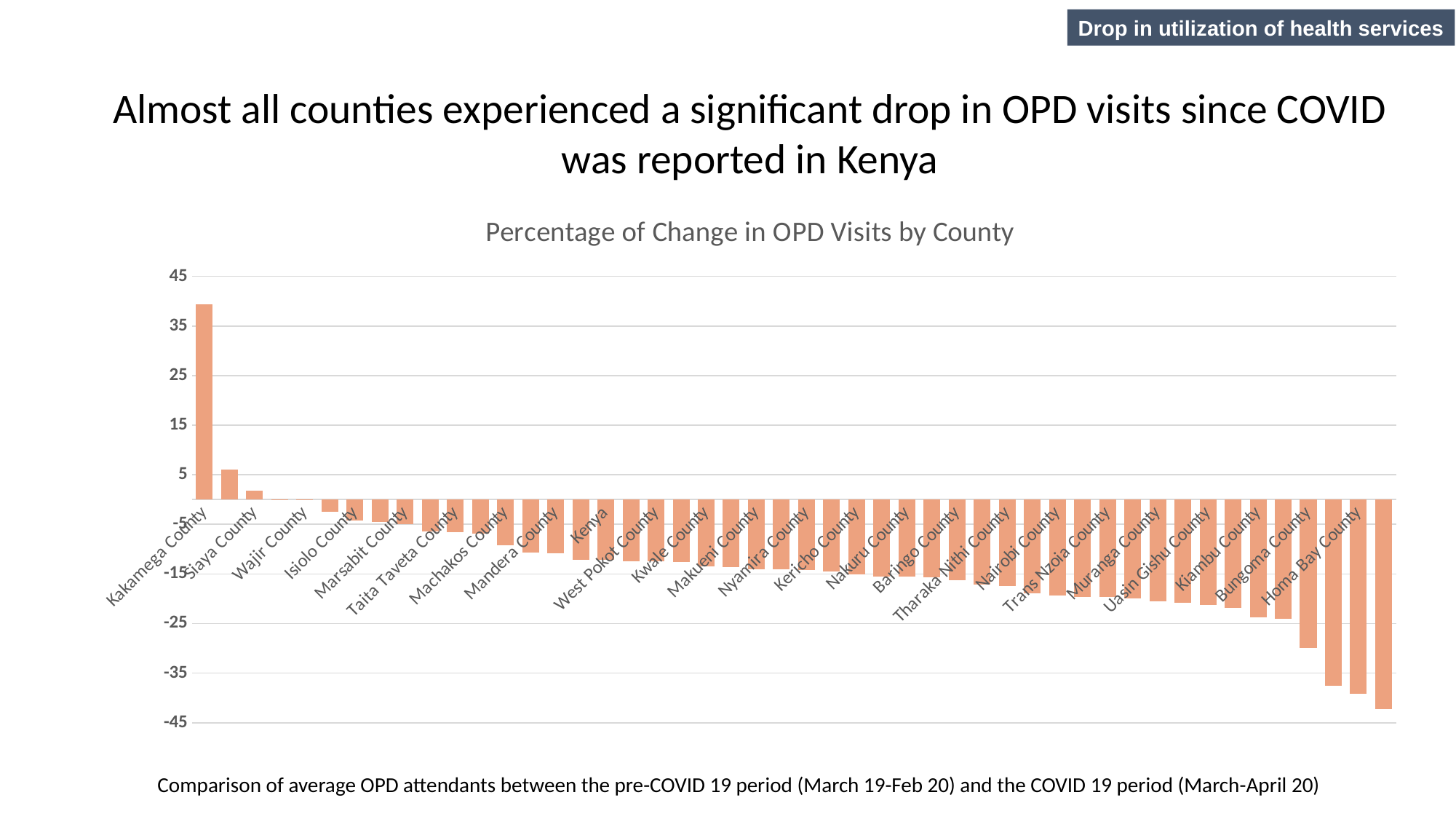
Is the value for Homa Bay County greater or less than -35? less Do the values generally rise or fall moving from left to right along the x axis? fall What is the title of the chart? Percentage of Change in OPD Visits by County Which has the larger value, Kakamega County or Siaya County? Kakamega County Which county has the highest percentage change in OPD visits? Kakamega County Which has the larger value, Bungoma County or Homa Bay County? Bungoma County Is the value for Bungoma County greater or less than -25? less Is the value for Kakamega County greater or less than 35? greater What kind of chart is shown on the slide? bar chart